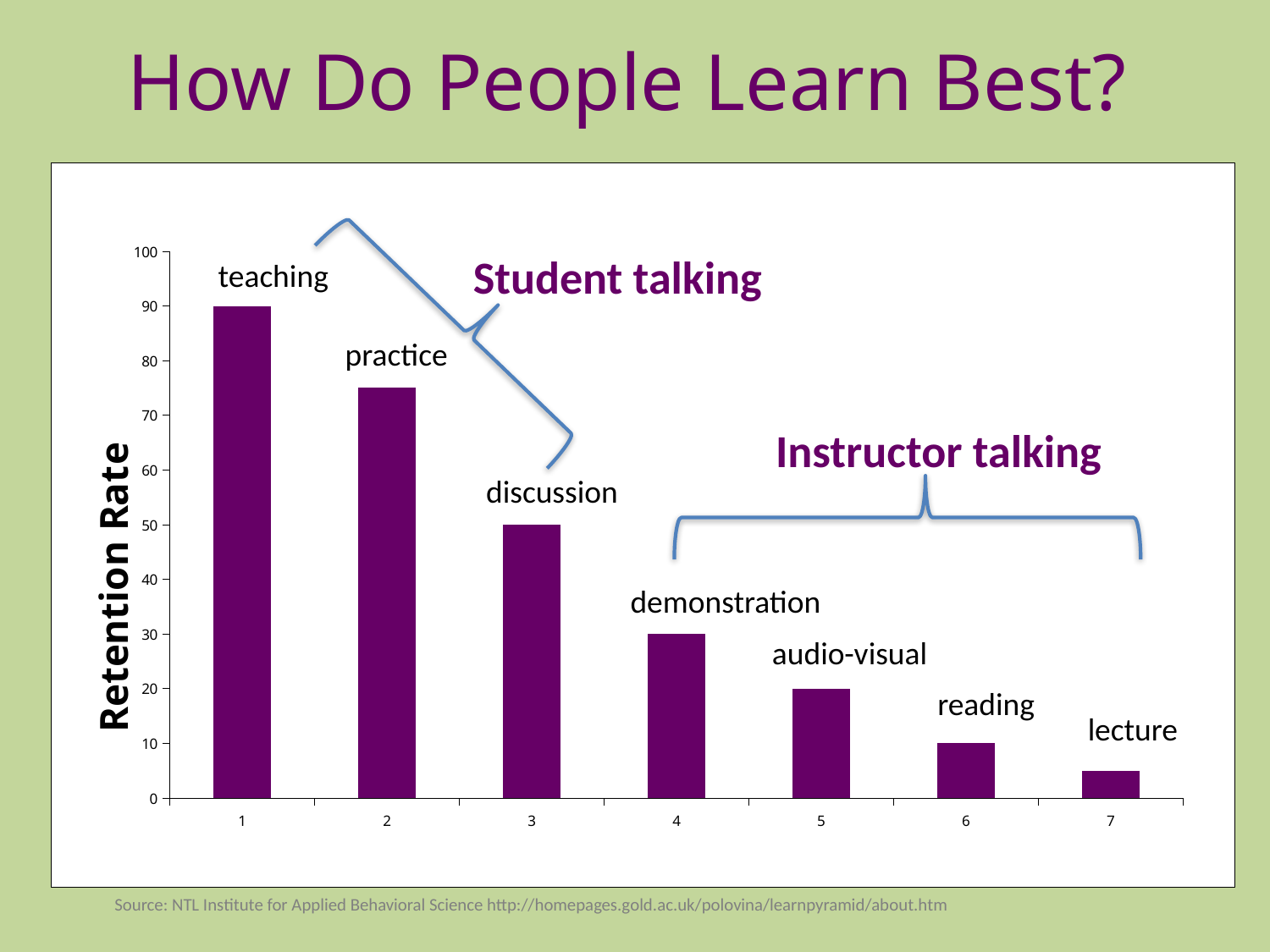
What is the retention rate for discussion? 50 What is the retention rate for teaching? 90 Do the retention rates rise or fall from left to right along the x axis? fall Is the value for lecture greater or less than 10? less What is the difference in retention rate between teaching and discussion? 40 Which learning method has the highest retention rate? teaching How many bars (learning methods) are plotted in the chart? 7 Is the value for practice greater or less than 70? greater What type of chart is shown on the slide? bar chart What is the retention rate for demonstration? 30 Which learning method has the lowest retention rate? lecture What is the retention rate for reading? 10